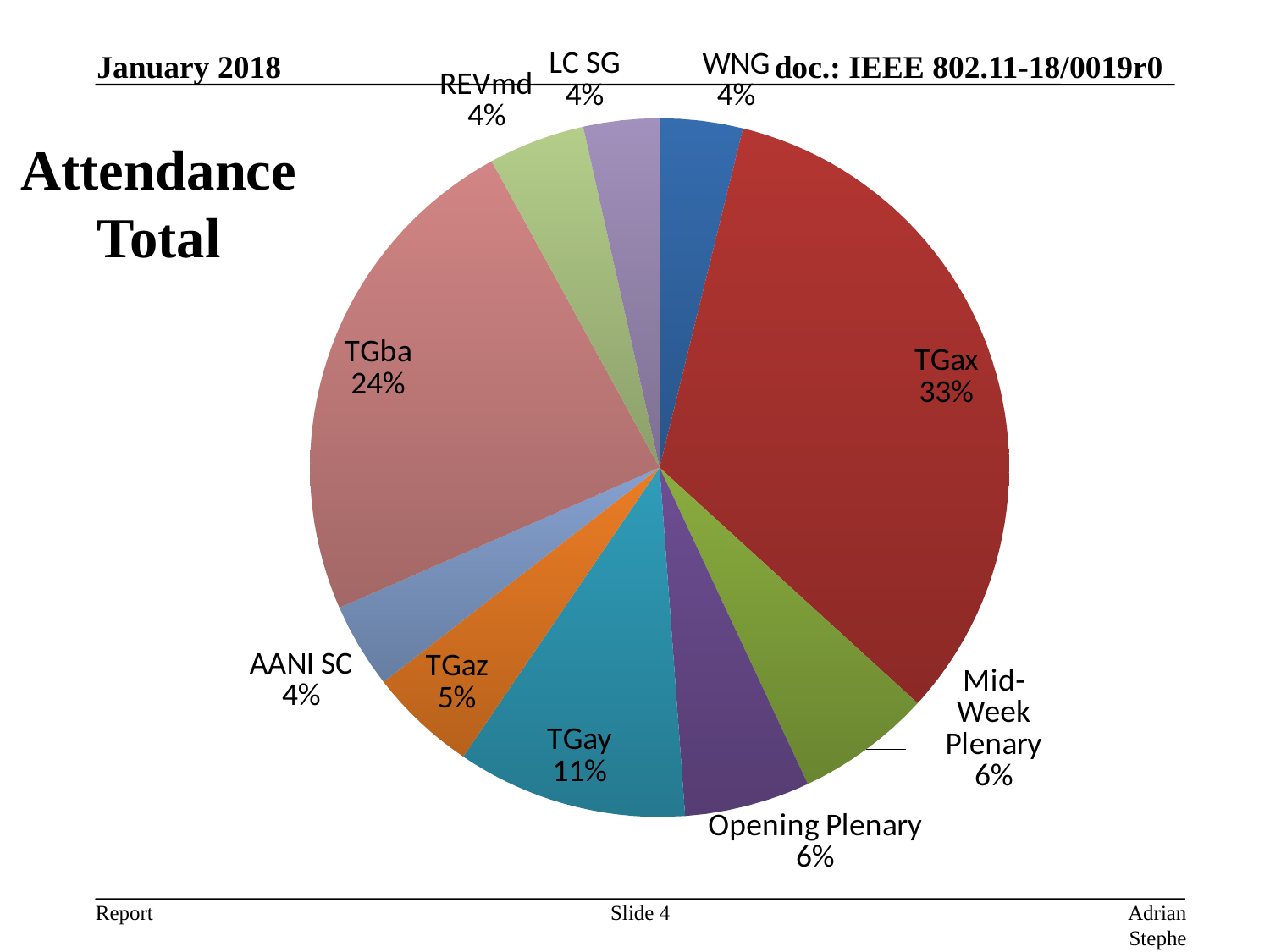
Which is larger, the share for TGba or the share for TGay? TGba What share of attendance does TGax account for? 33% What share of attendance does the Mid-Week Plenary account for? 6% Which category has the largest slice of the pie? TGax What is the title of the chart? Attendance Total What share of attendance does AANI SC account for? 4% What kind of chart is shown on the slide? pie chart What is the difference in percentage points between the TGax share and the TGba share? 9 How many slices does the pie chart have? 10